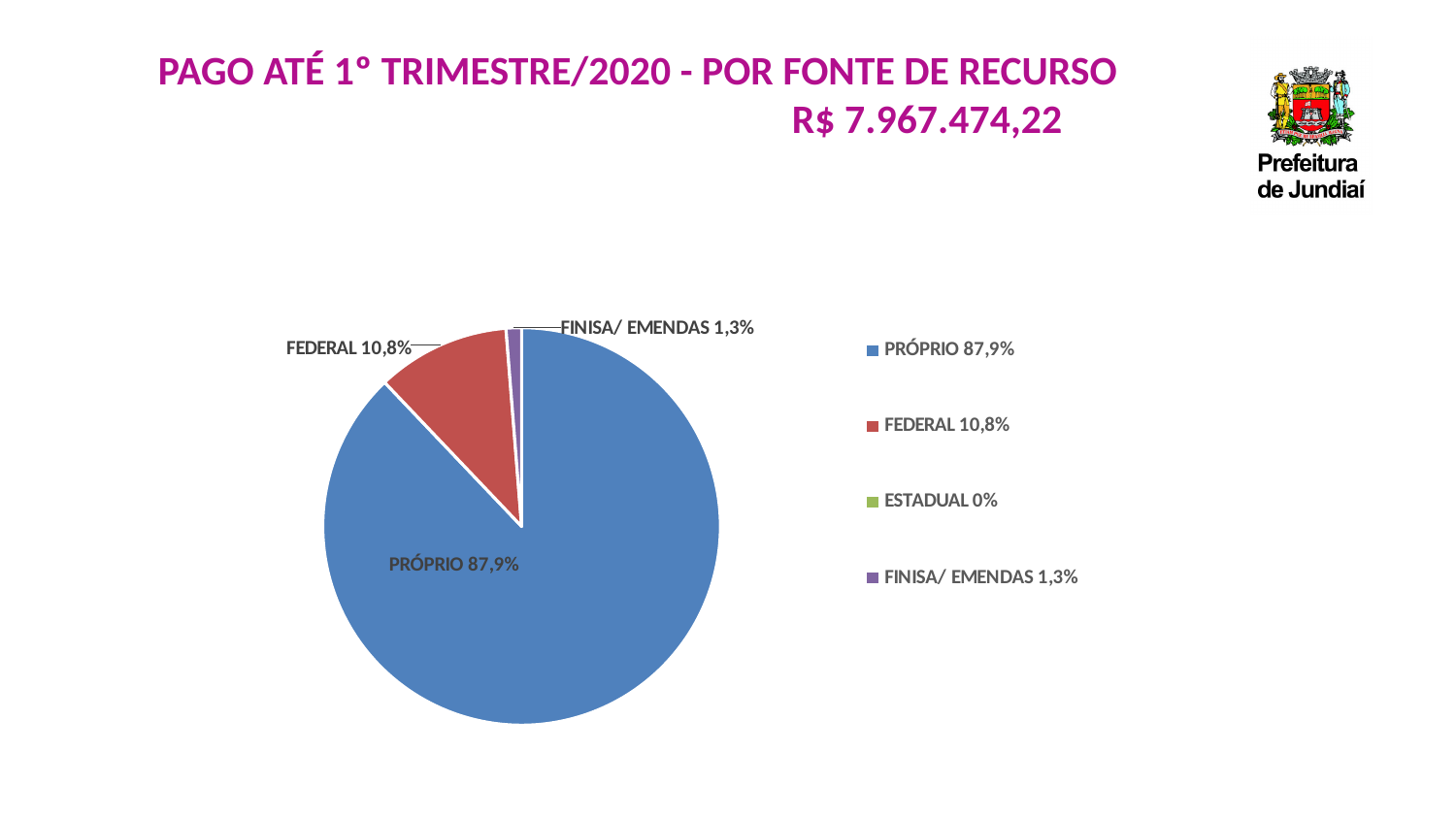
Which source of funds has the largest slice of the pie? PRÓPRIO What colour is the FEDERAL slice of the pie? red How many entries does the legend list? 4 What total amount is shown in the chart title? R$ 7.967.474,22 What share does ESTADUAL have according to the legend? 0% What share of the pie does FINISA/ EMENDAS represent? 1,3% What kind of chart is shown on the slide? pie chart What share of the pie does FEDERAL represent? 10,8% Which is larger, the FEDERAL share or the FINISA/ EMENDAS share? FEDERAL What share of the pie does PRÓPRIO represent? 87,9% What is the difference in percentage points between the PRÓPRIO and FEDERAL shares? 77,1 Which source of funds has the smallest share according to the legend? ESTADUAL